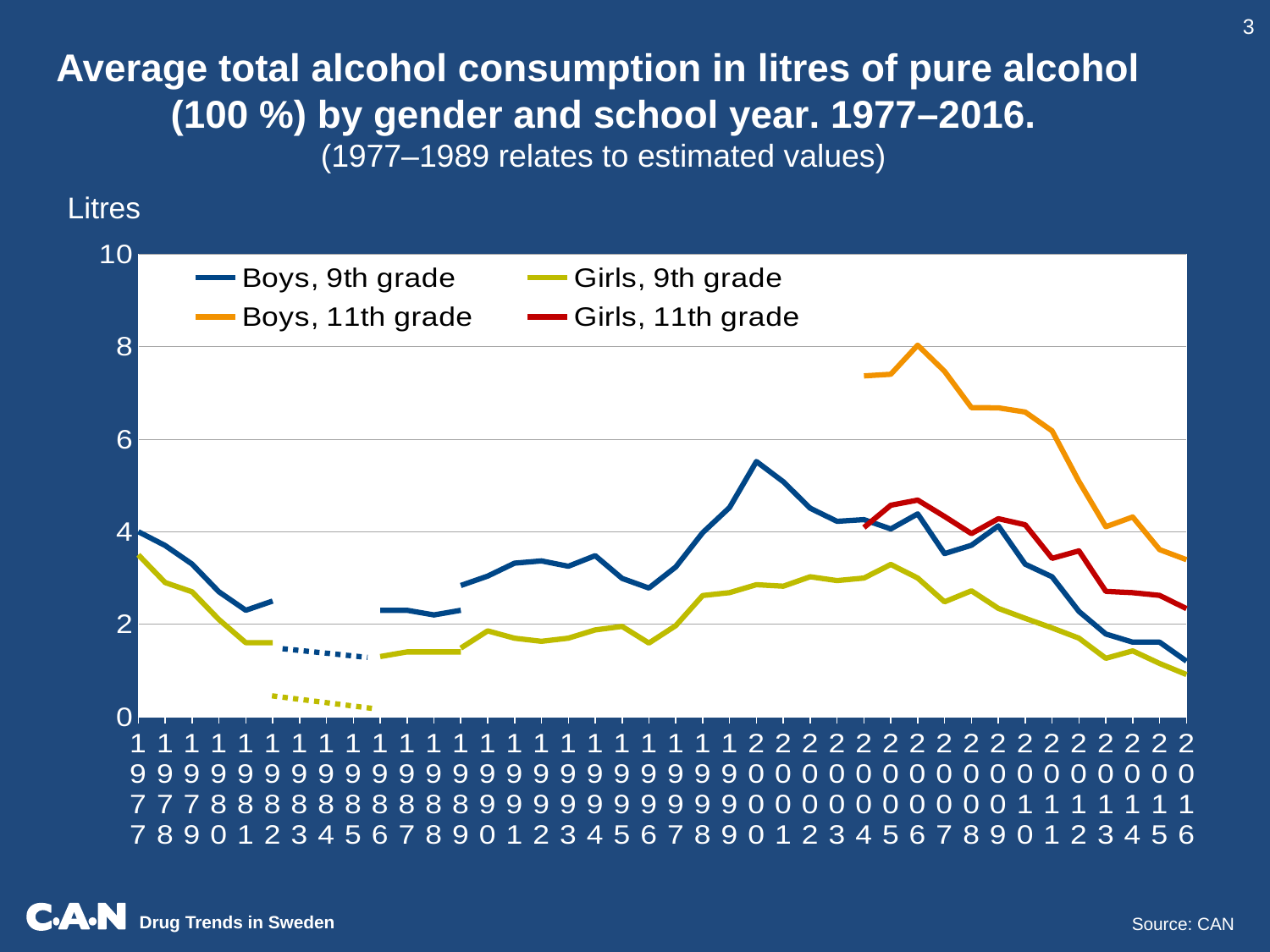
Which series has the lowest value in 2016? Girls, 9th grade Which series has the highest value in 2006? Boys, 11th grade Does the Boys, 11th grade line rise or fall from 2006 to 2016? fall What kind of chart is shown on the slide? line chart Is the value for Girls, 9th grade in 2016 greater or less than 2? less What unit is shown on the y axis label? Litres Is the value for Boys, 11th grade in 2006 greater or less than 6? greater Is the value for Girls, 11th grade in 2016 greater or less than 4? less How many years are shown along the x axis? 40 How many series does the legend list? 4 In 2000, which is larger: the value for Boys, 9th grade or Girls, 9th grade? Boys, 9th grade